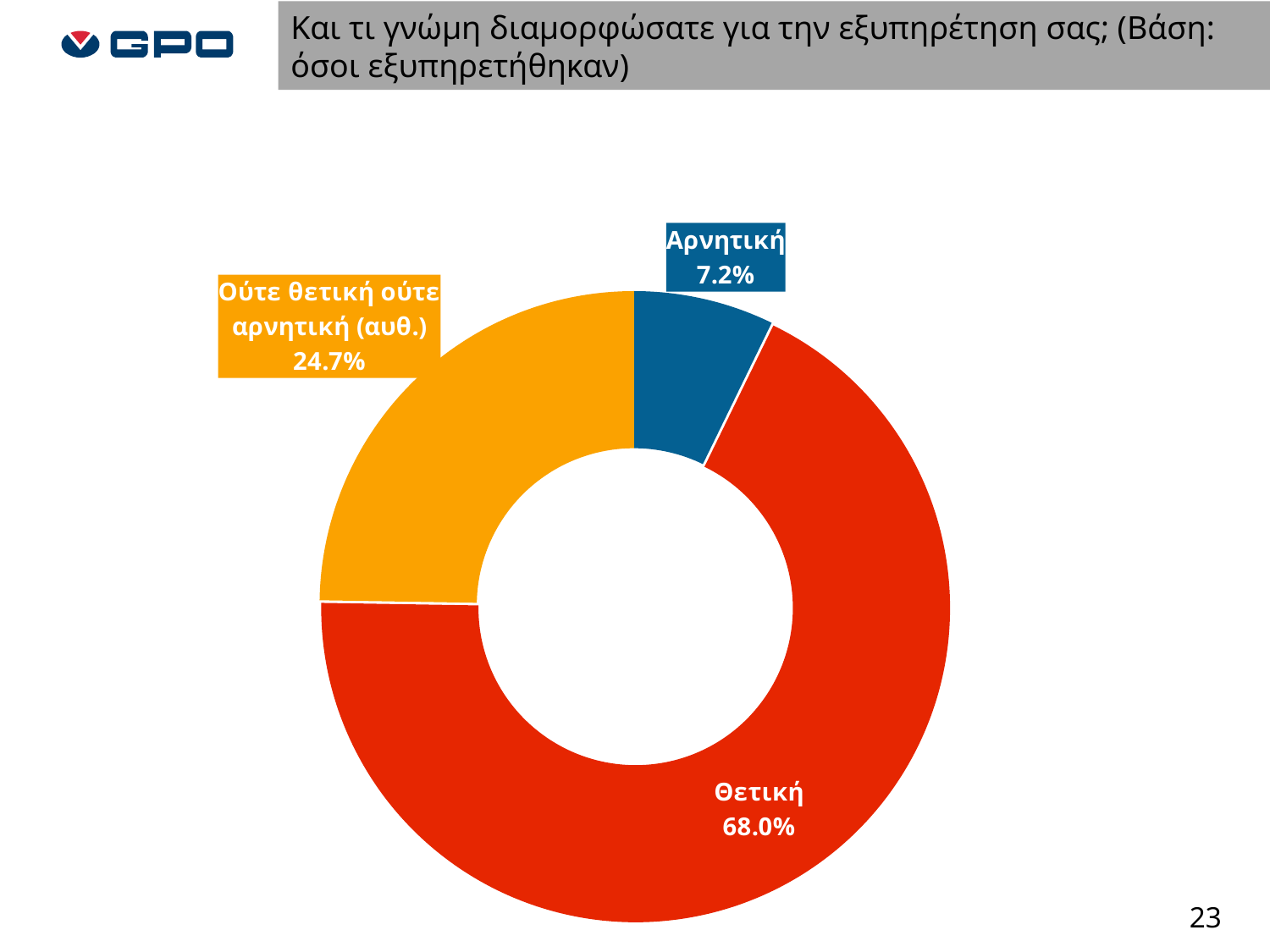
What colour is the Αρνητική segment of the chart? Blue Which category has the largest share of the chart? Θετική How many categories are shown in the chart? 3 What is the difference in percentage points between Ούτε θετική ούτε αρνητική (αυθ.) and Αρνητική? 17.5 What percentage of respondents answered Αρνητική? 7.2% What colour is the Θετική segment of the chart? Red What percentage of respondents answered Θετική? 68.0% What is the difference in percentage points between Θετική and Ούτε θετική ούτε αρνητική (αυθ.)? 43.3 What kind of chart is shown on the slide? Doughnut (pie) chart Which is larger, the share for Αρνητική or the share for Ούτε θετική ούτε αρνητική (αυθ.)? Ούτε θετική ούτε αρνητική (αυθ.) Which category has the smallest share of the chart? Αρνητική What percentage of respondents answered Ούτε θετική ούτε αρνητική (αυθ.)? 24.7%